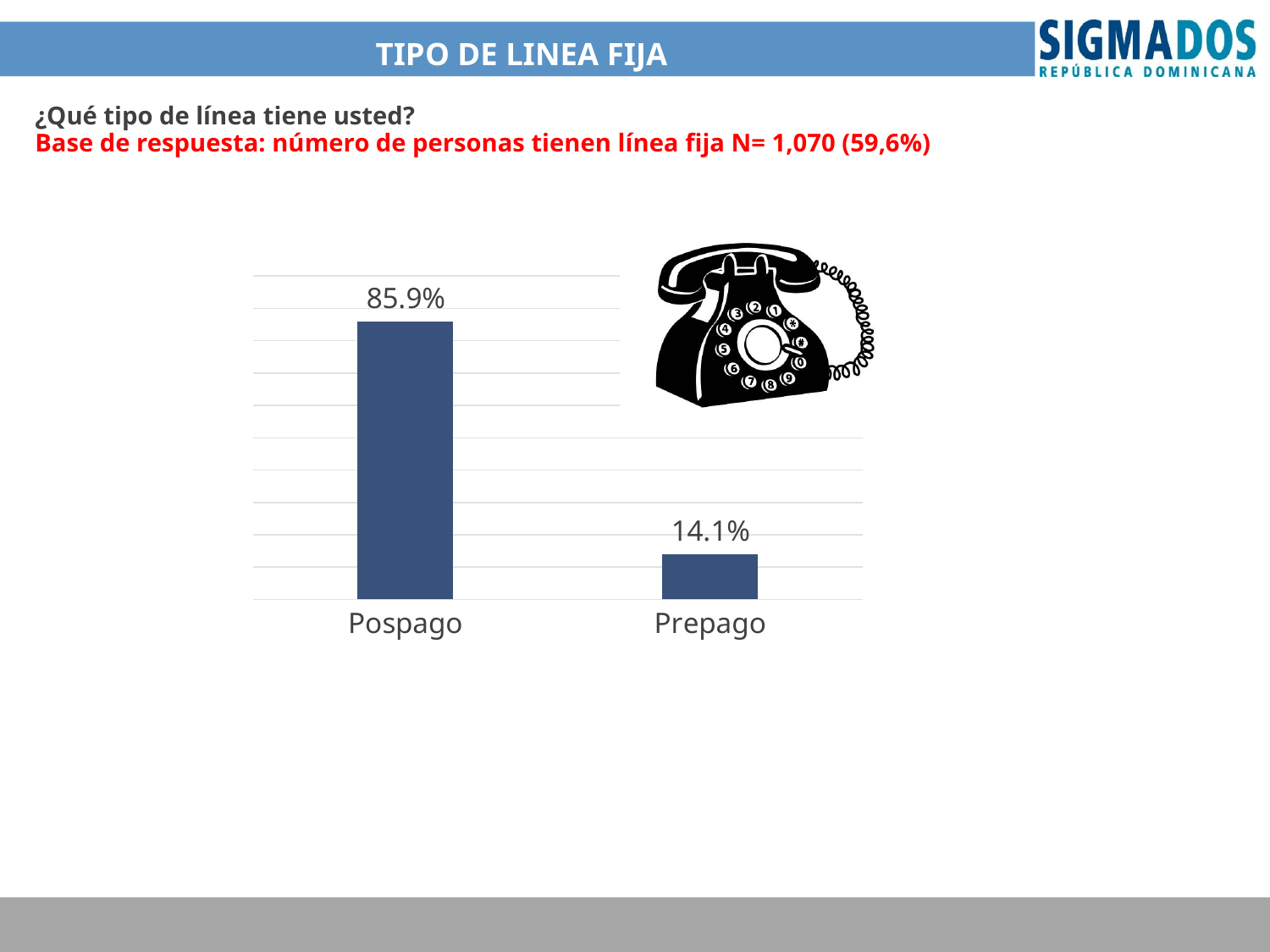
How many categories are shown in the chart? 2 What is the value for Prepago? 14.1% Which is larger, the value for Pospago or the value for Prepago? Pospago What is the difference between the values for Pospago and Prepago? 71.8% What is the total of the two values shown in the chart? 100% What is the value for Pospago? 85.9% Do the values rise or fall from Pospago to Prepago? Fall Which category has the highest value? Pospago Which category has the lowest value? Prepago What is the title shown in the header bar of the slide? TIPO DE LINEA FIJA What kind of chart is shown on the slide? Bar chart What is the base N stated on the slide for people with a fixed line? 1,070